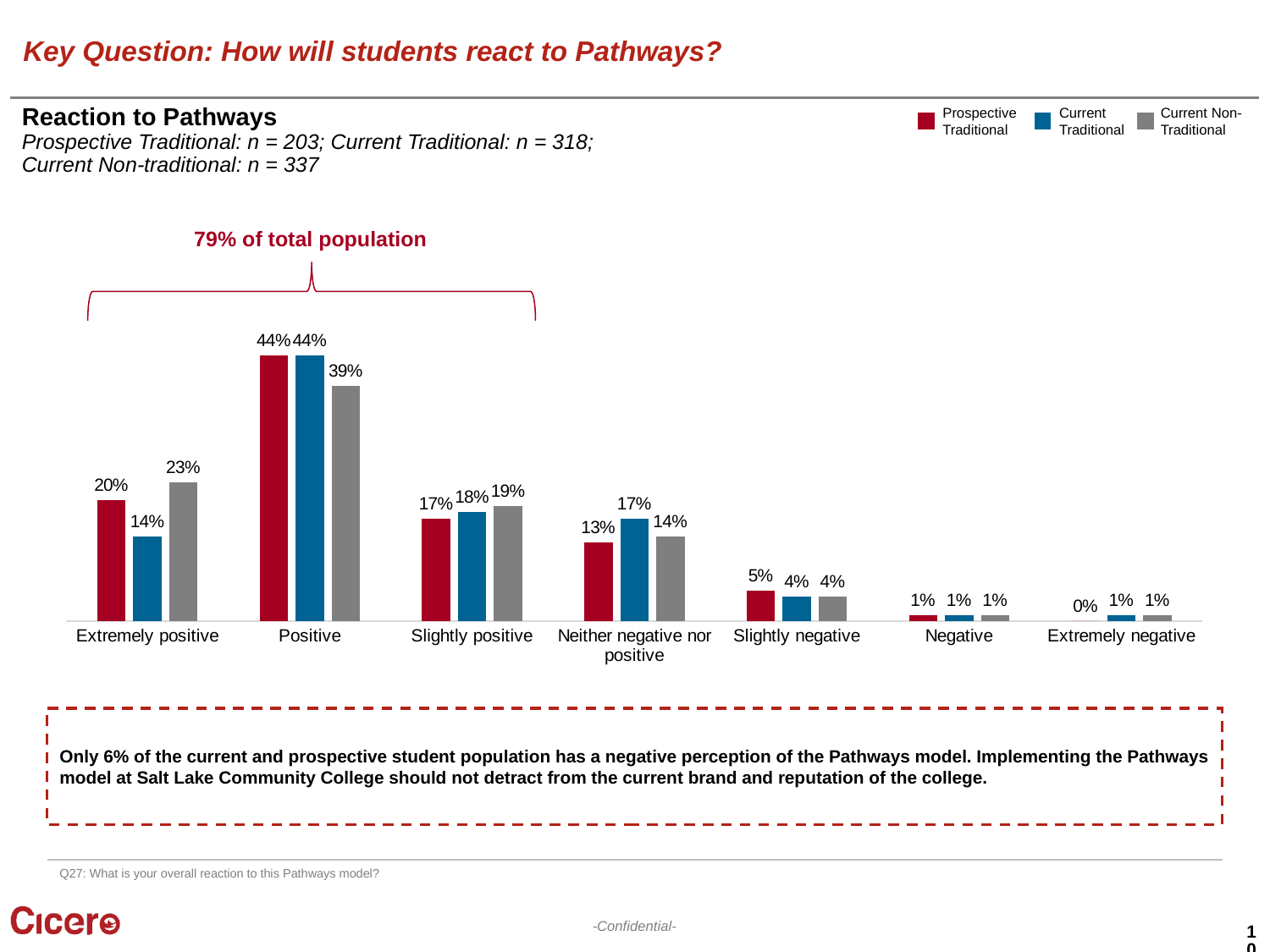
What share of the total population does the bracket over the first two categories indicate? 79% What kind of chart is shown on the slide? Bar chart Which category has the highest value for Current Non-Traditional? Positive What is the value for Current Traditional in the Neither negative nor positive category? 17% What is the value for Current Non-Traditional in the Extremely positive category? 23% What is the difference between the Prospective Traditional and Current Traditional values in the Extremely positive category? 6% How many reaction categories are shown on the x axis? 7 How many series does the legend list? 3 What is the value for Prospective Traditional in the Positive category? 44% In the Positive category, which is larger: Current Traditional or Current Non-Traditional? Current Traditional What is the value for Prospective Traditional in the Slightly negative category? 5% Which category has the lowest value for Prospective Traditional? Extremely negative